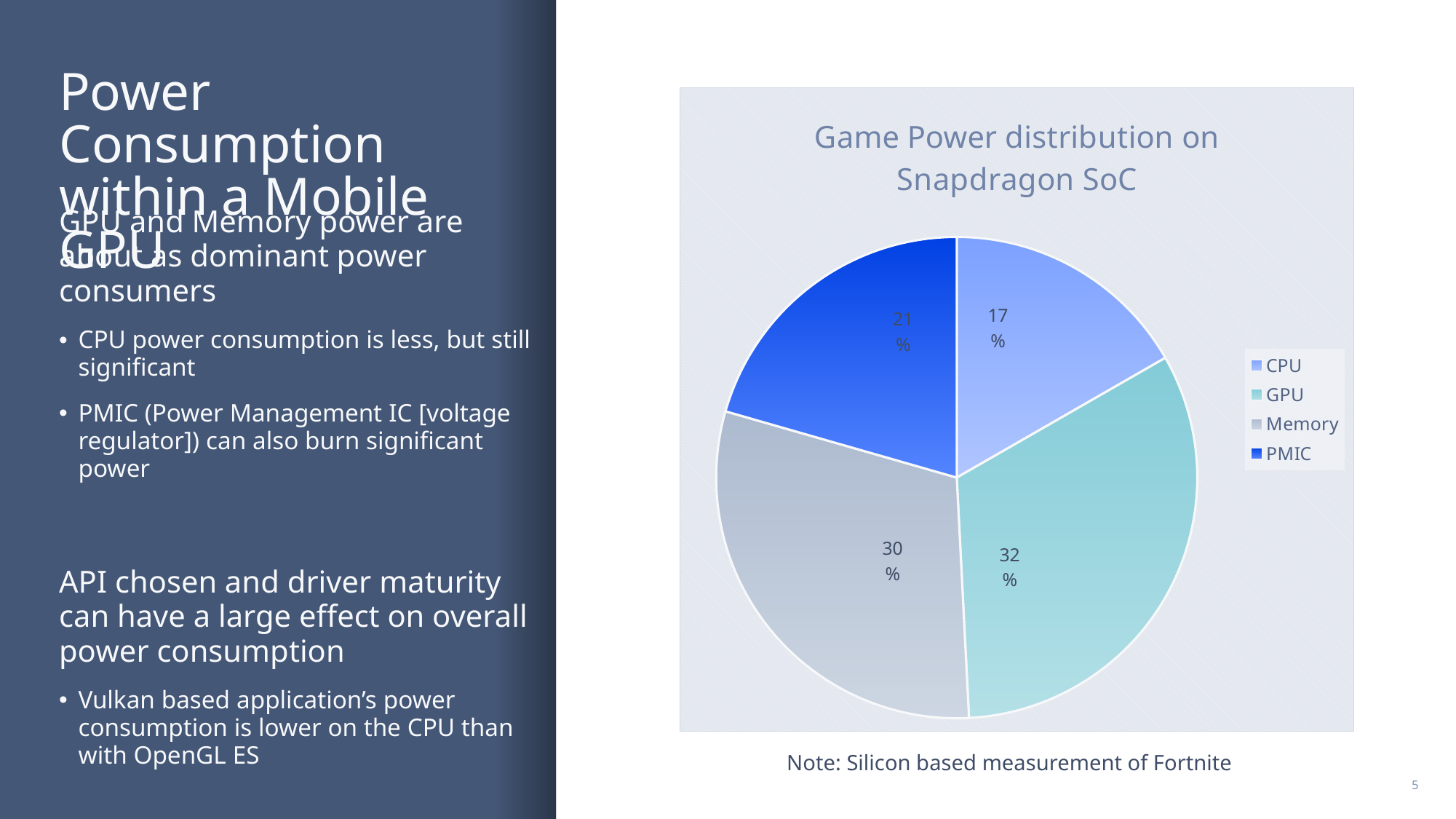
What share of game power does the PMIC consume according to the chart? 21% What type of chart is shown on the slide? pie chart What is the title of the chart? Game Power distribution on Snapdragon SoC How many slices does the pie chart have? 4 What share of game power does the GPU consume according to the chart? 32% How many entries does the chart legend list? 4 Which component has the smallest share of game power in the chart? CPU Which has a larger share of game power, PMIC or Memory? Memory What is the difference in percentage points between the GPU share and the CPU share? 15 Which component has the largest share of game power in the chart? GPU What share of game power does the CPU consume according to the chart? 17% What share of game power does Memory consume according to the chart? 30%